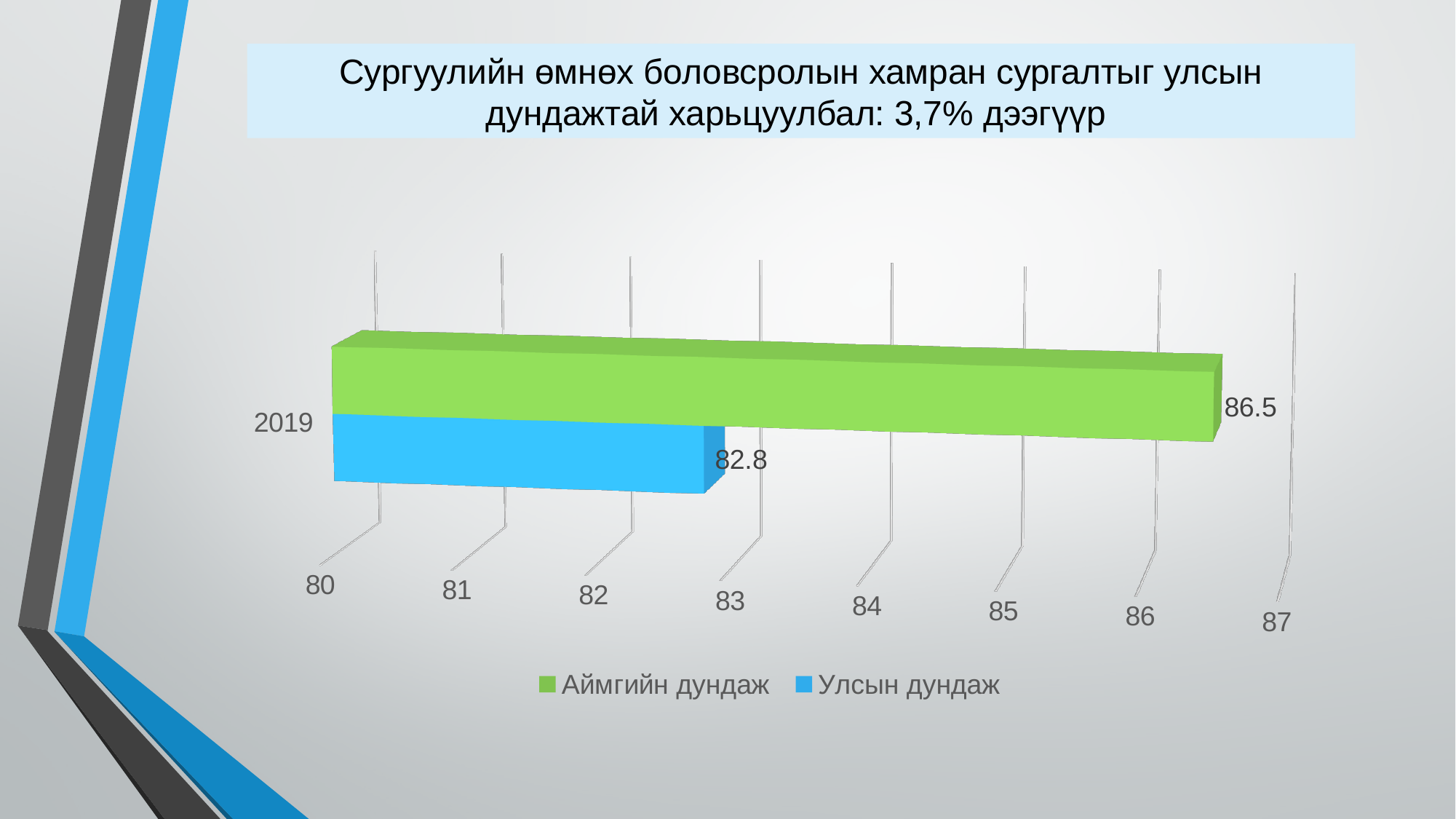
Which year is shown as the category on the chart? 2019 Which series has the lowest value on the chart? Улсын дундаж What kind of chart is shown on the slide? bar chart What colour is the bar for Улсын дундаж? blue How many categories are shown on the category axis? 1 What is the difference between the Аймгийн дундаж and Улсын дундаж values for 2019? 3.7 Which series has the higher value in 2019, Аймгийн дундаж or Улсын дундаж? Аймгийн дундаж What is the value for Улсын дундаж in 2019? 82.8 How many series does the legend list? 2 Is the value for Аймгийн дундаж greater or less than 86? greater What is the value for Аймгийн дундаж in 2019? 86.5 Is the value for Улсын дундаж greater or less than 83? less